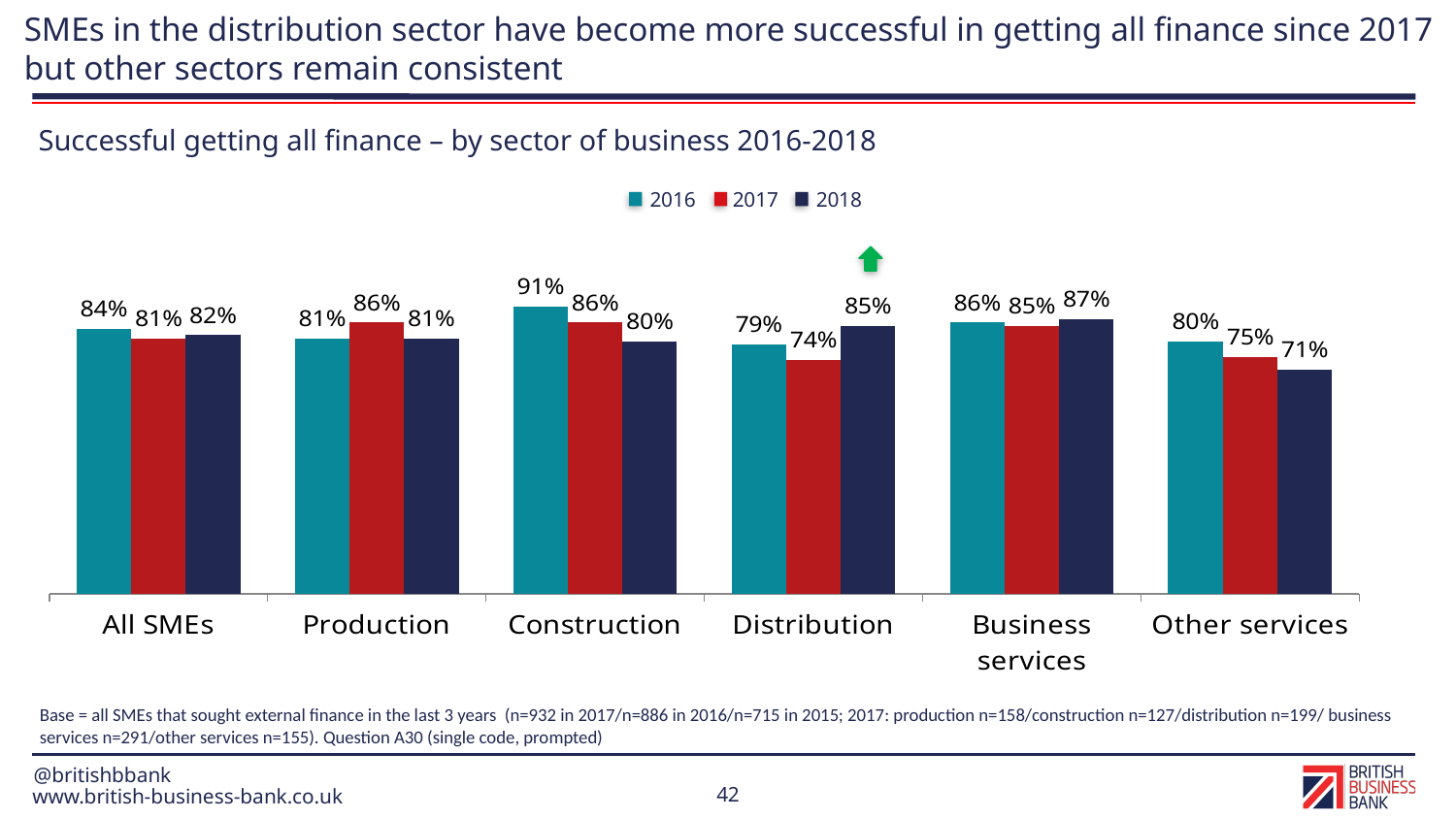
How many sectors (categories) are shown on the x axis? 6 What was the value for Other services in 2017? 75% What kind of chart is shown? Bar chart How many series does the legend list? 3 What was the value for Distribution in 2018? 85% What was the value for Construction in 2016? 91% Do the values for Other services rise or fall from 2016 to 2018? Fall Which is larger for Production: the 2016 value or the 2017 value? 2017 Which sector had the lowest value in 2017? Distribution Which sector had the highest value in 2018? Business services What is the title of the chart? Successful getting all finance – by sector of business 2016-2018 What is the difference between the 2017 and 2018 values for Distribution? 11 percentage points